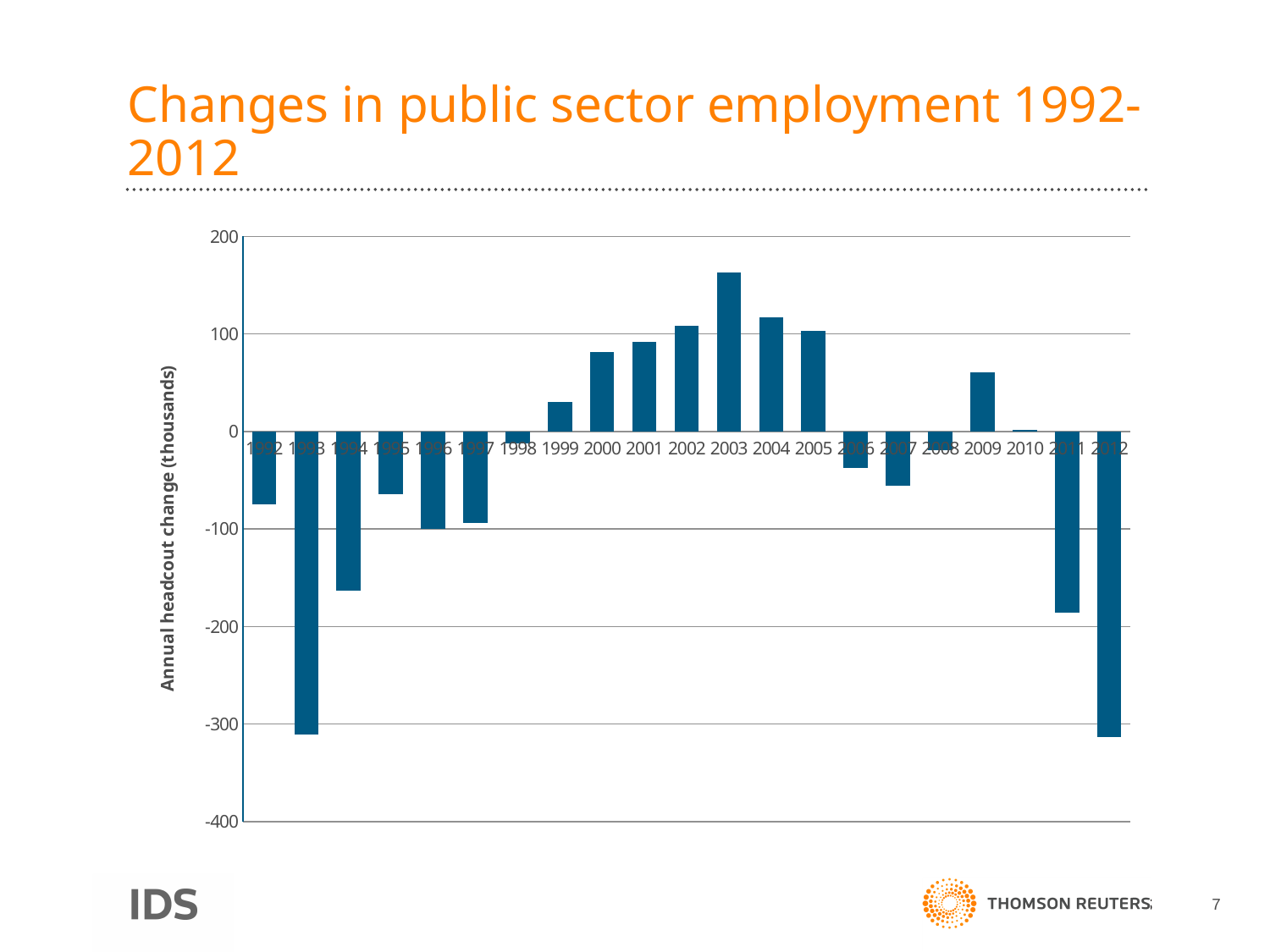
What is the label on the vertical axis of the chart? Annual headcount change (thousands) Which year has the larger value, 2003 or 2004? 2003 Is the value for 2009 greater or less than 100? less Which year has the larger value, 1994 or 2011? 1994 Is the value for 2003 greater or less than 100? greater Is the value for 1994 greater or less than -100? less Which year has the highest annual headcount change? 2003 How many years (bars) are plotted on the chart? 21 Do the values rise or fall from 1999 to 2003? rise What kind of chart is shown on the slide? Bar chart